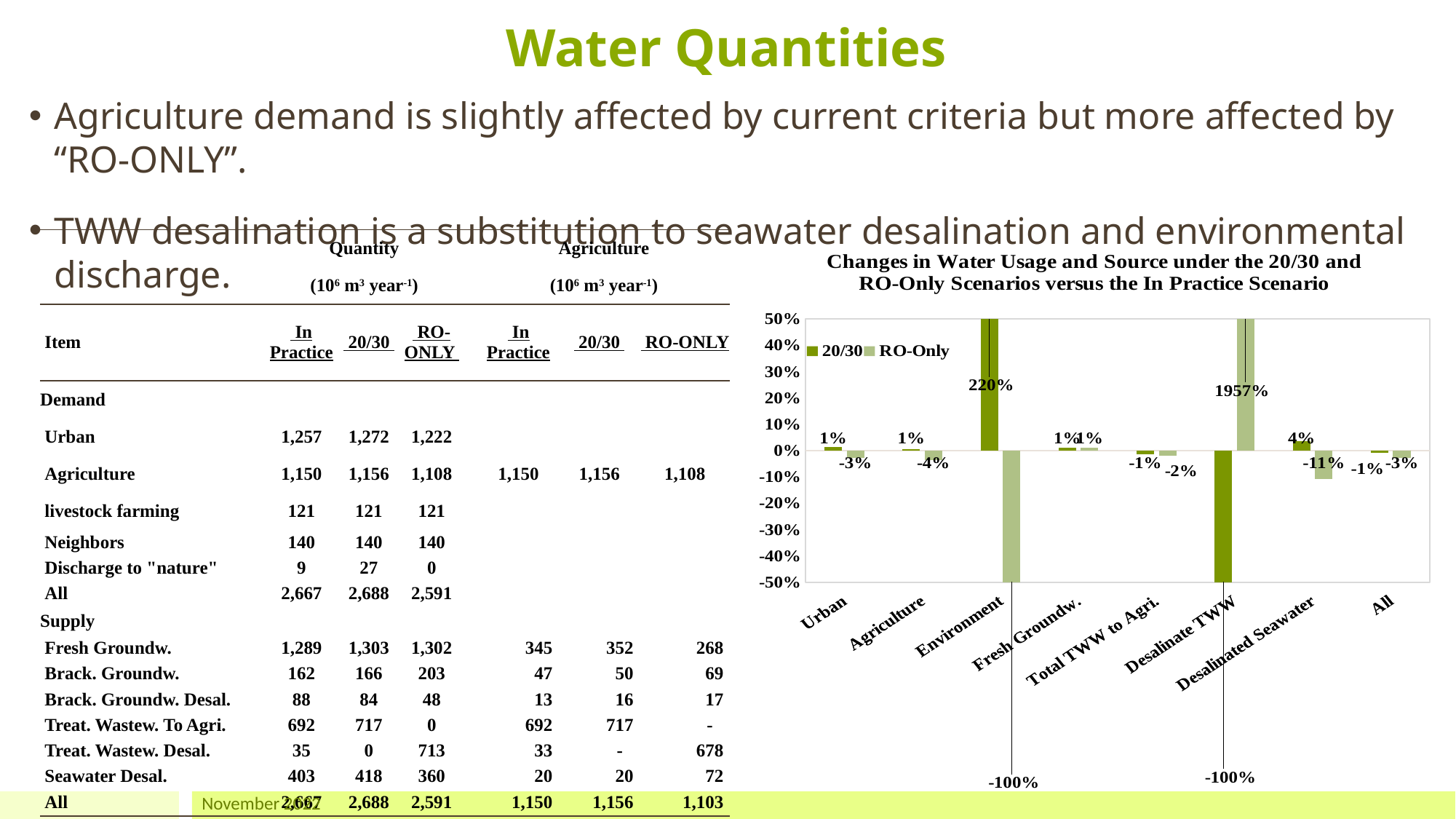
In the chart 'Changes in Water Usage and Source', what is the RO-Only value for Agriculture? -4% In the chart 'Changes in Water Usage and Source', what is the RO-Only value for Desalinated Seawater? -11% In the chart 'Changes in Water Usage and Source', how many categories are shown on the x axis? 8 In the chart 'Changes in Water Usage and Source', which category has the highest 20/30 value? Environment In the chart 'Changes in Water Usage and Source', what is the 20/30 value for Environment? 220% In the chart 'Changes in Water Usage and Source', how many series does the legend list? 2 What kind of chart is shown on the right side of the slide? bar chart In the chart 'Changes in Water Usage and Source', which is larger for Urban: the 20/30 value or the RO-Only value? 20/30 In the chart 'Changes in Water Usage and Source', which category has the highest RO-Only value? Desalinate TWW In the chart 'Changes in Water Usage and Source', what is the difference between the 20/30 value for Desalinated Seawater and the 20/30 value for Urban? 3% In the chart 'Changes in Water Usage and Source', what is the RO-Only value for Desalinate TWW? 1957% In the chart 'Changes in Water Usage and Source', what is the 20/30 value for Desalinate TWW? -100%